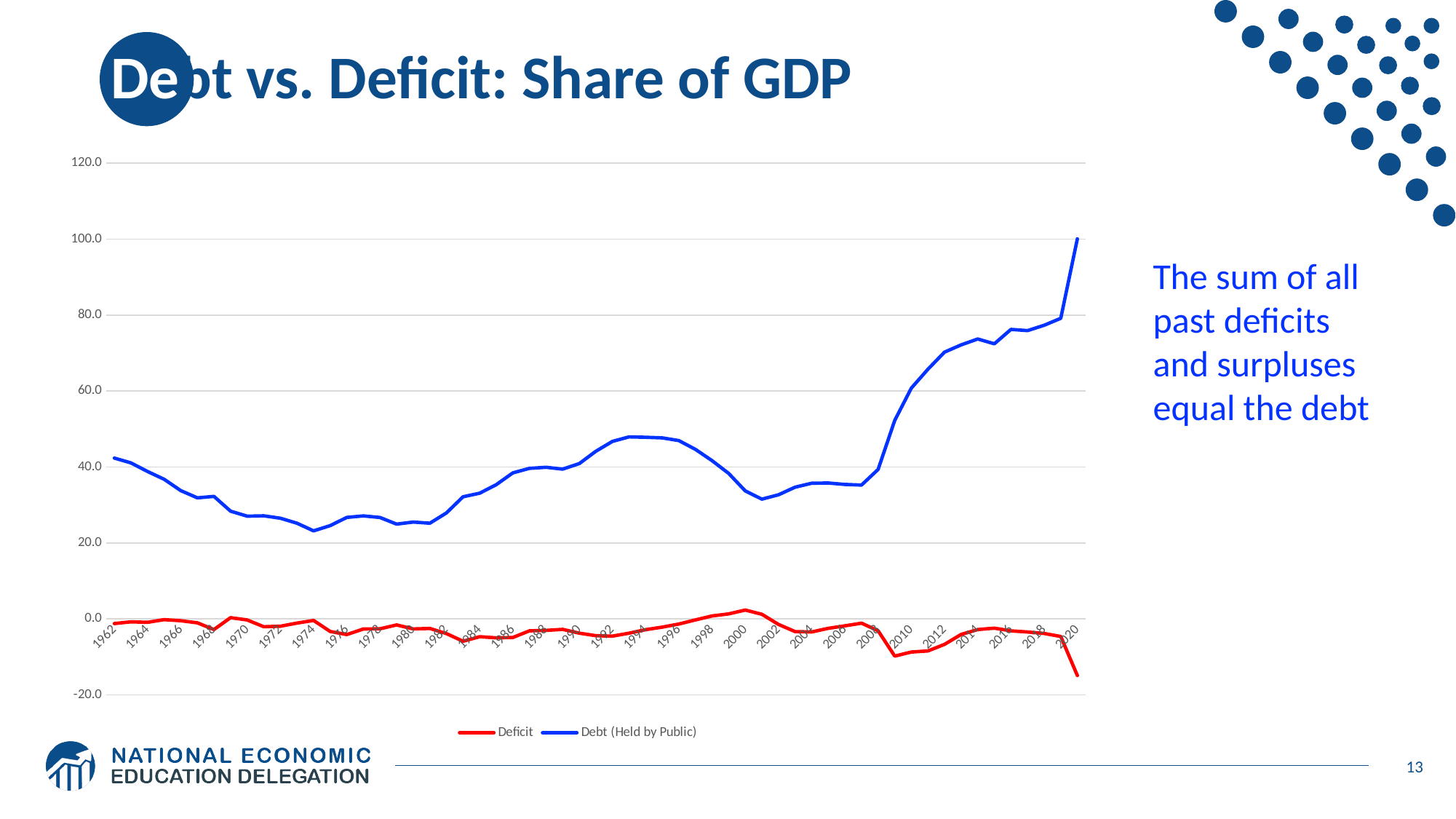
Which series has the larger value in 2010, Deficit or Debt (Held by Public)? Debt (Held by Public) Is the value for Deficit in 2020 greater or less than 0.0? less Does the Debt (Held by Public) series rise or fall between 2008 and 2020? rise Is the value for Debt (Held by Public) in 2012 greater or less than 60.0? greater What are the two series named in the legend? Deficit and Debt (Held by Public) In which year does the Deficit series reach its lowest value? 2020 What is the title of the chart on the slide? Debt vs. Deficit: Share of GDP What kind of chart is shown on the slide? line chart In which year does the Debt (Held by Public) series reach its highest value? 2020 Is the value for Debt (Held by Public) in 2020 greater or less than 80.0? greater How many series does the legend list? 2